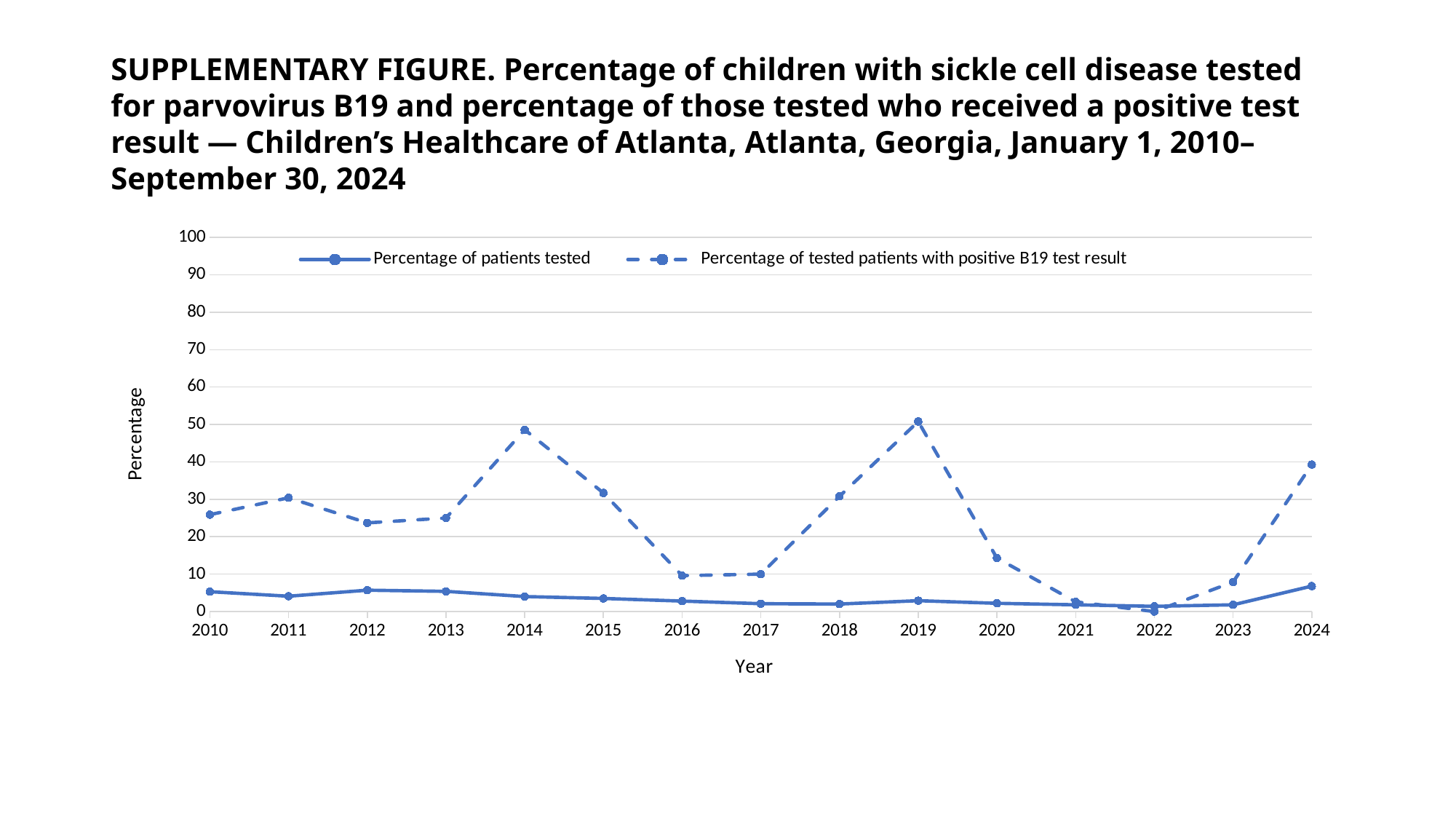
Is the percentage of patients tested in 2024 greater or less than 10? less How many series does the legend list? 2 What kind of chart is shown on the slide? line chart In which year is the percentage of tested patients with a positive B19 test result lowest? 2022 How many years are plotted along the x axis? 15 Is the percentage of tested patients with a positive B19 test result in 2014 greater or less than 40? greater Is the percentage of tested patients with a positive B19 test result in 2019 greater or less than 40? greater What is the label on the y axis? Percentage Which year has the higher percentage of tested patients with a positive B19 test result, 2014 or 2016? 2014 Does the percentage of patients tested rise or fall from 2013 to 2017? fall